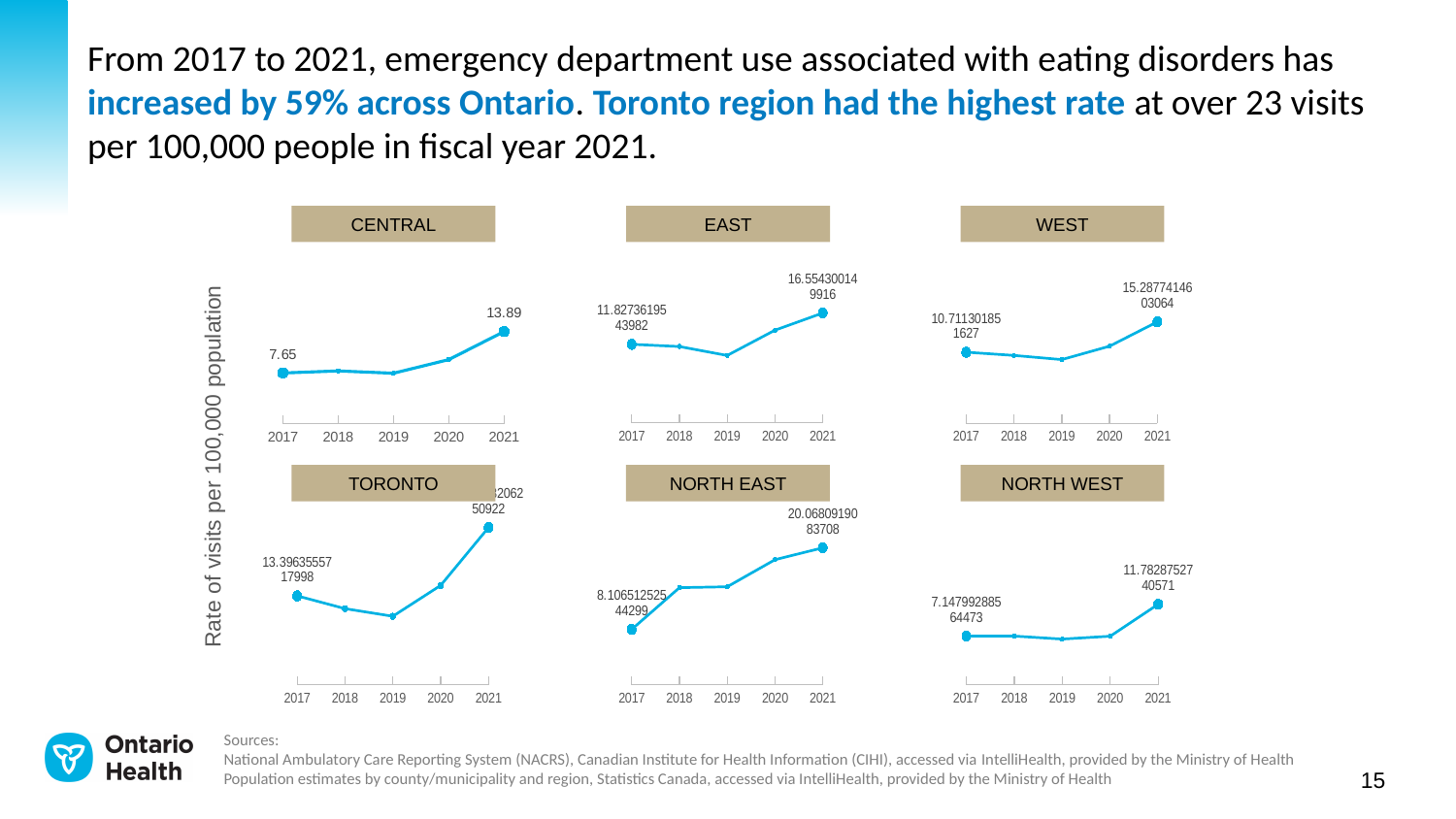
In the CENTRAL chart, which year has the highest value? 2021 What type of chart is used for the CENTRAL region? line chart Which region's chart is shown in the bottom-right position on the slide? NORTH WEST In the EAST chart, is the value for 2021 larger or smaller than the value for 2017? larger In the CENTRAL chart, what is the difference between the 2021 and 2017 values? 6.24 In the CENTRAL chart, how many data points are plotted? 5 In the CENTRAL chart, what is the rate of visits per 100,000 population in 2017? 7.65 How many charts are shown on the slide? 6 What is the label on the shared vertical axis of the charts? Rate of visits per 100,000 population In the NORTH EAST chart, do the values overall rise or fall from 2017 to 2021? rise In the TORONTO chart, which year has the lowest value? 2019 In the CENTRAL chart, what is the rate of visits per 100,000 population in 2021? 13.89